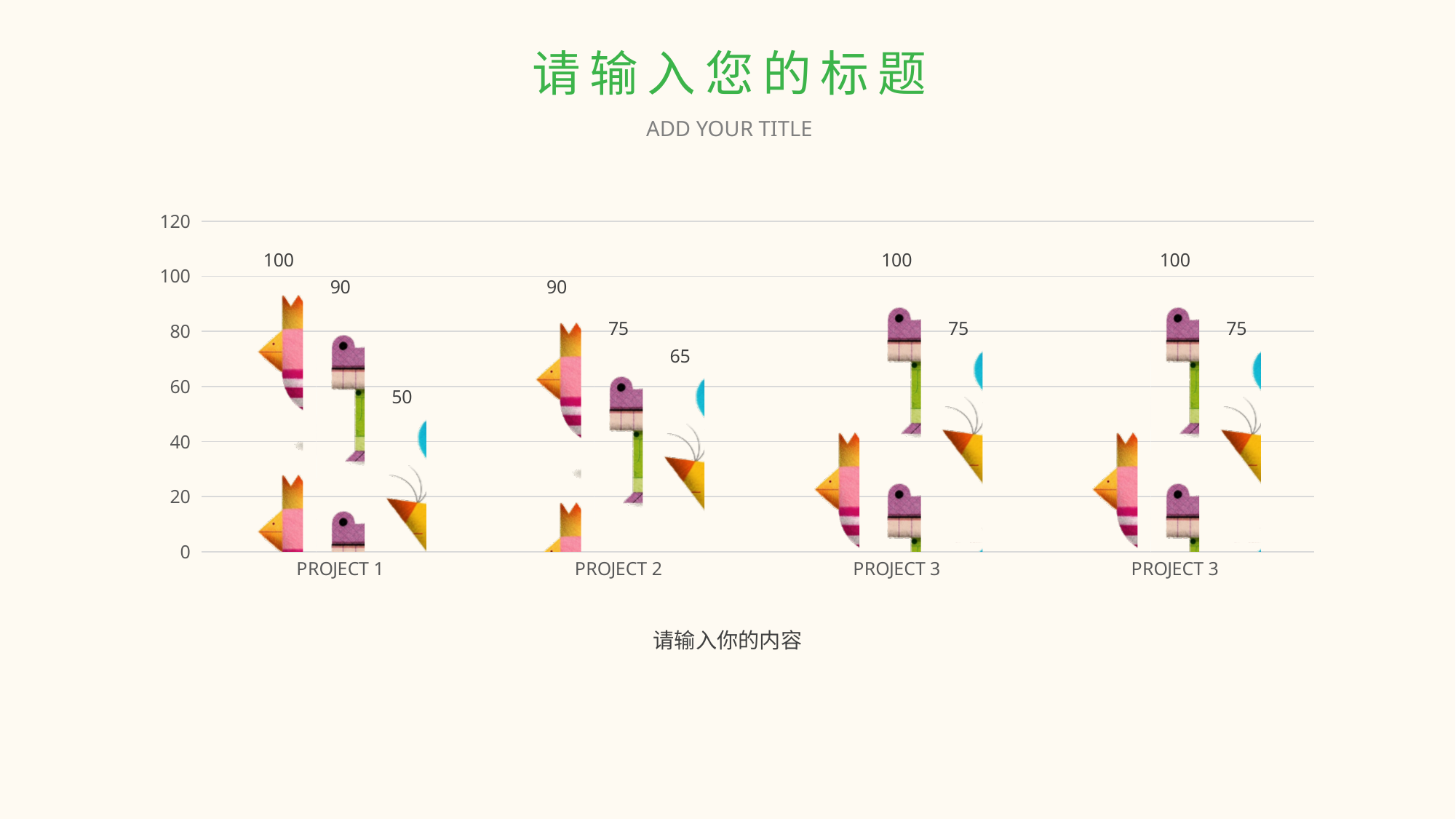
What is the highest value labelled in the PROJECT 2 group? 90 What is the value of the third bar in the PROJECT 1 group? 50 What is the difference between the first bar and the second bar in the PROJECT 2 group? 15 Is the value of the third bar in the third category group (the first PROJECT 3 group) greater or less than 60? greater What is the value of the first (leftmost) bar in the PROJECT 1 group? 100 Which category label appears twice on the x axis of the chart? PROJECT 3 What is the value of the second bar in the PROJECT 2 group? 75 How many category groups are shown along the x axis of the chart? 4 Which is larger: the first bar in PROJECT 1 or the first bar in PROJECT 2? PROJECT 1 What kind of chart is shown on the slide? bar chart What is the value of the third bar in the PROJECT 2 group? 65 What is the difference between the first bar and the third bar in the PROJECT 1 group? 50